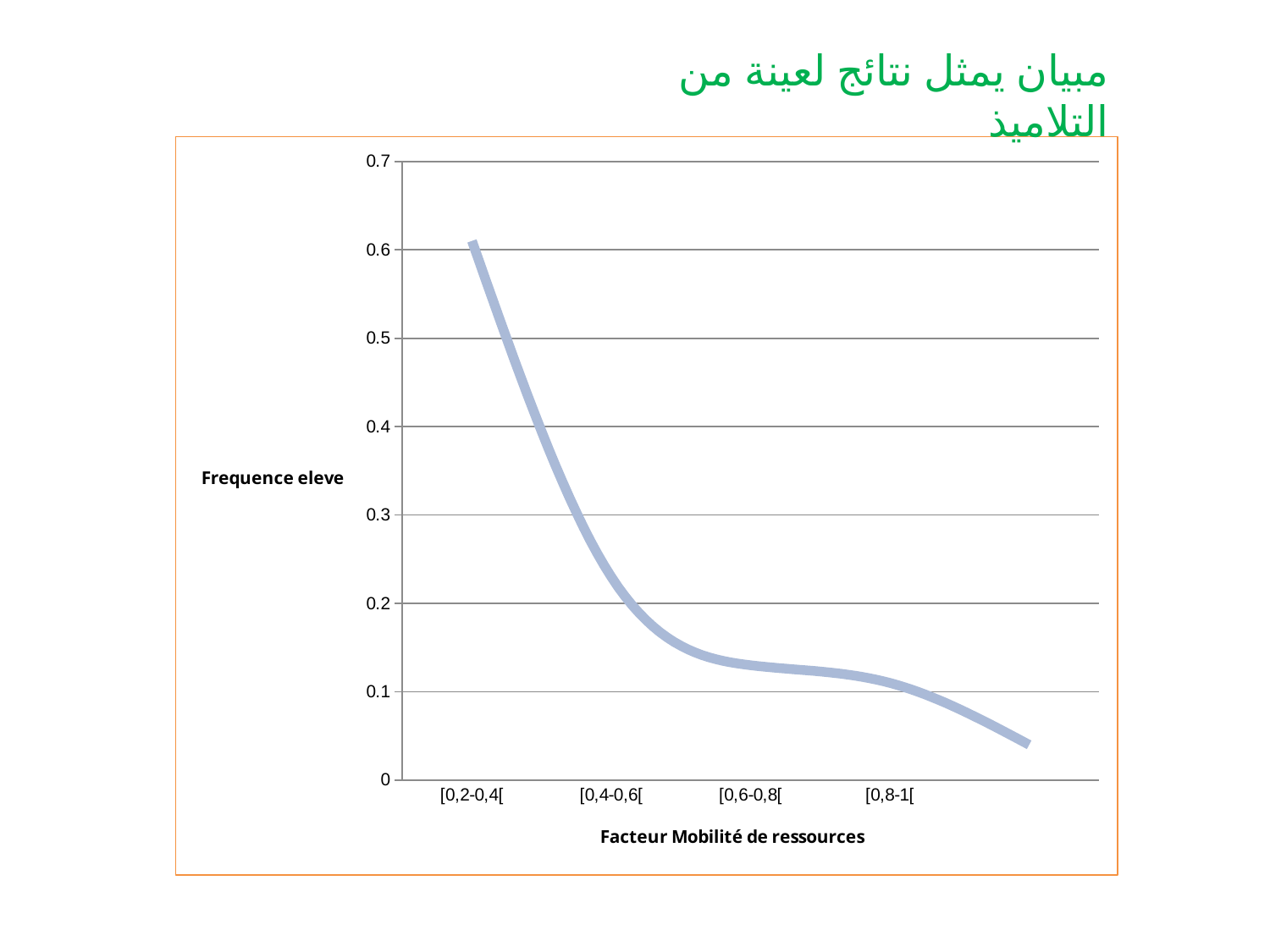
Which is larger, the value for [0,4-0,6[ or the value for [0,8-1[? [0,4-0,6[ Is the value for [0,4-0,6[ greater or less than 0.3? less Is the value for [0,2-0,4[ greater or less than 0.5? greater How many category labels are shown on the x axis? 4 What is the title of the vertical axis? Frequence eleve Which is larger, the value for [0,2-0,4[ or the value for [0,4-0,6[? [0,2-0,4[ Which category has the highest Frequence eleve value? [0,2-0,4[ Is the value for [0,6-0,8[ greater or less than 0.2? less What is the title of the horizontal axis? Facteur Mobilité de ressources Do the values rise or fall as you move from left to right along the x axis? fall What kind of chart is shown on the slide? line chart